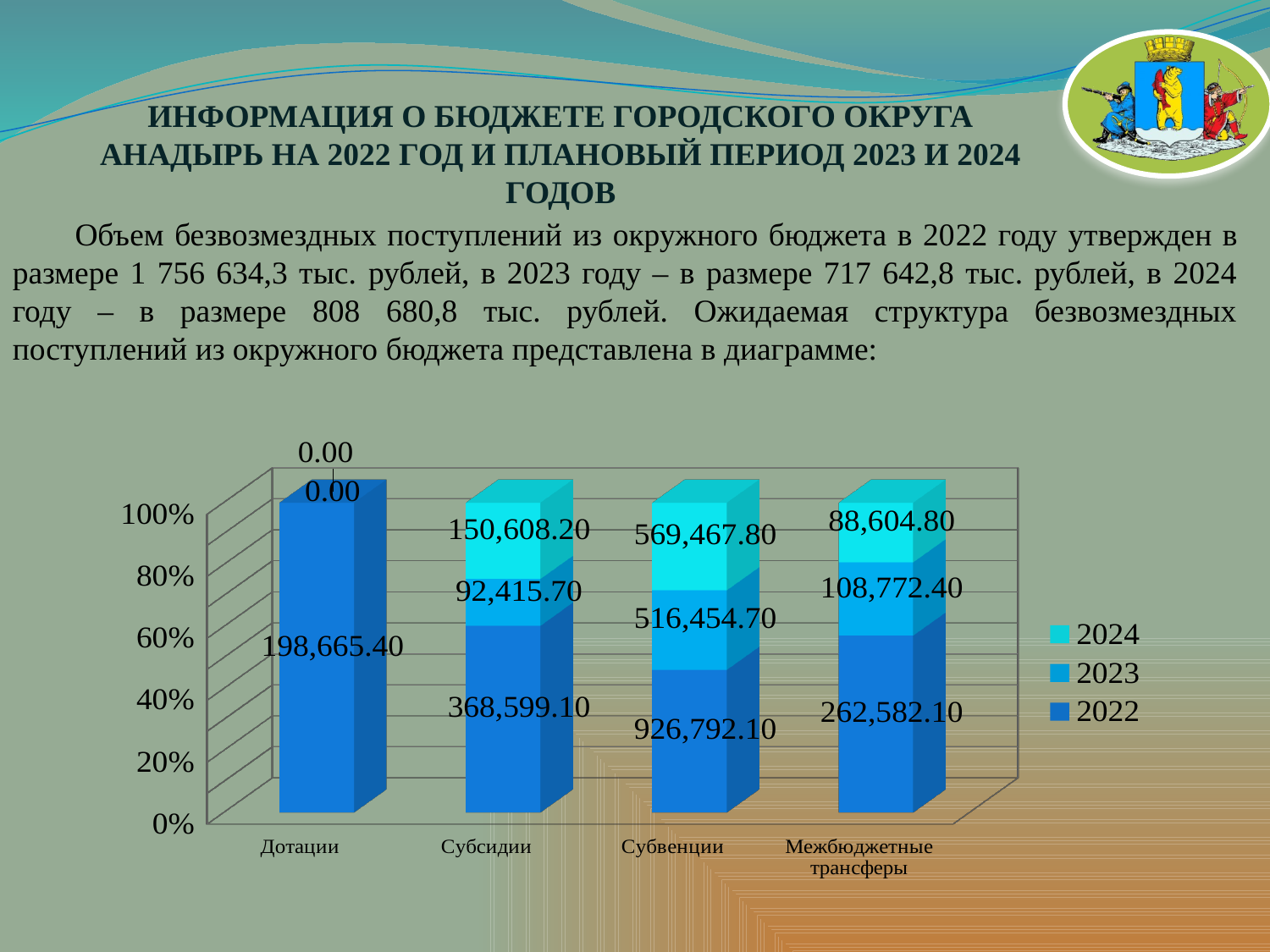
What is the 2022 value for Субвенции? 926,792.10 How many series does the legend list? 3 What kind of chart is shown on the slide? Stacked bar chart How many categories are shown on the x axis? 4 Which category has the highest 2022 value? Субвенции Which category has the lowest 2022 value? Дотации What is the 2023 value for Дотации? 0.00 What is the difference between the 2024 and 2023 values for Субвенции? 53,013.10 Which is larger for Межбюджетные трансферы: the 2023 value or the 2024 value? 2023 What is the total of the three values stacked for Субсидии? 611,623.00 What is the 2023 value for Межбюджетные трансферы? 108,772.40 What is the 2024 value for Субсидии? 150,608.20